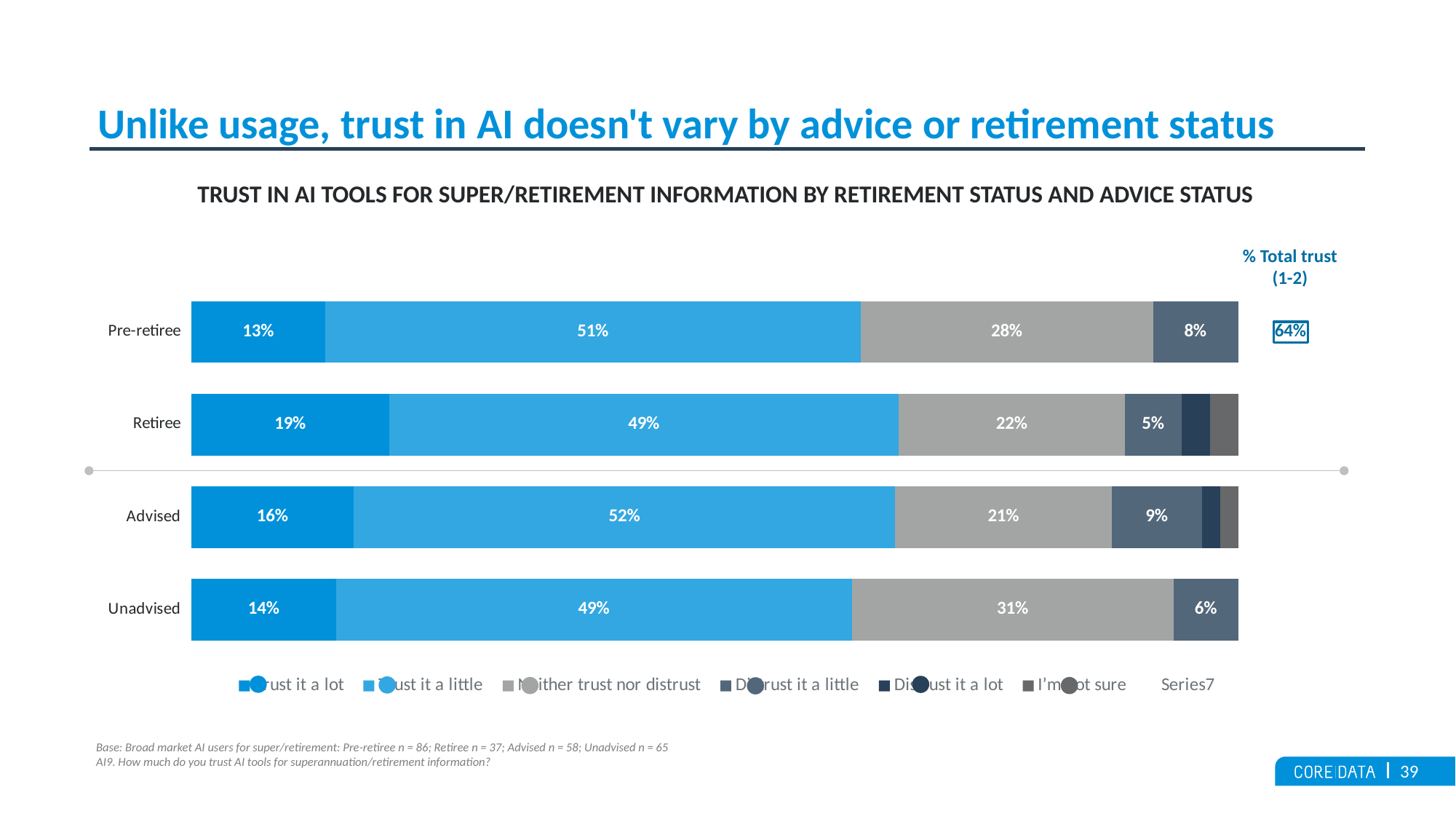
What percentage of Retirees say they trust AI tools a lot? 19% Which is larger: the 'Distrust it a little' value for Advised or for Pre-retiree? Advised What is the % Total trust (1-2) shown for Pre-retirees? 64% Which group has the highest 'Trust it a lot' percentage? Retiree What is the 'Trust it a little' value for Pre-retirees? 51% How many groups (categories) are shown on the chart? 4 How many series does the legend list? 7 Which group has the highest 'Neither trust nor distrust' percentage? Unadvised What is the difference in percentage points between the 'Trust it a little' values for Advised and Unadvised? 3 percentage points Which group has the lowest 'Trust it a lot' percentage? Pre-retiree What kind of chart is shown on the slide? Stacked bar chart What is the 'Neither trust nor distrust' value for the Unadvised group? 31%